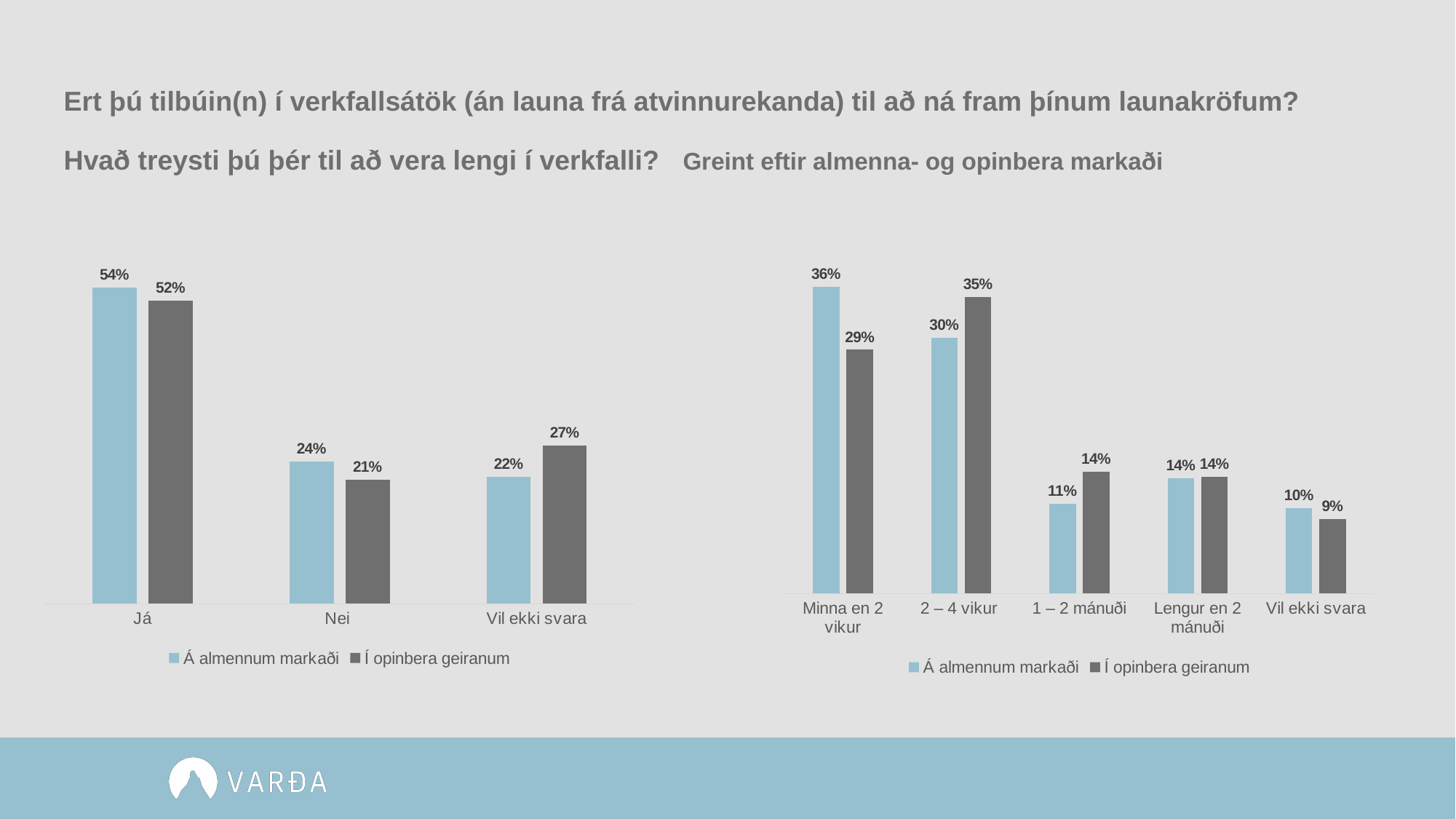
What kind of chart is the left chart? Bar chart In the left chart, what is the value for 'Nei' in the 'Í opinbera geiranum' series? 21% In the left chart, how many categories are shown on the x axis? 3 In the right chart, which series has the larger value for '1 – 2 mánuði'? Í opinbera geiranum In the left chart, what is the difference between the two series for 'Vil ekki svara'? 5% In the right chart, what is the value for '2 – 4 vikur' in the 'Í opinbera geiranum' series? 35% In the right chart, what is the difference between the two series for 'Minna en 2 vikur'? 7% In the right chart, which category has the lowest value for 'Í opinbera geiranum'? Vil ekki svara In the right chart, what is the value for 'Minna en 2 vikur' in the 'Á almennum markaði' series? 36% In the left chart, what is the value for 'Já' in the 'Á almennum markaði' series? 54% How many series does the legend of the right chart list? 2 In the left chart, which category has the highest value for 'Í opinbera geiranum'? Já